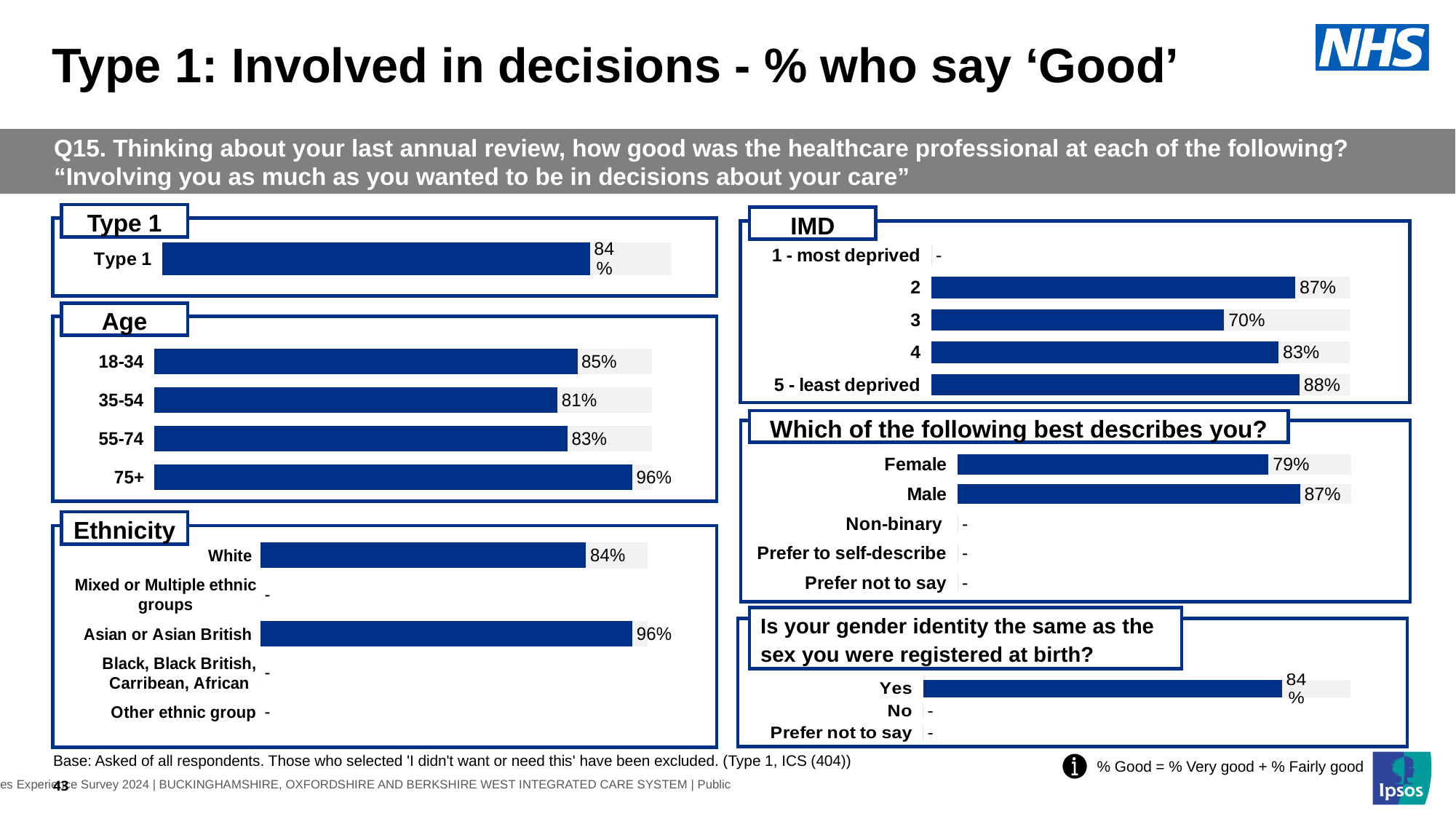
In the Ethnicity chart, what is the value for Asian or Asian British? 96% In the Ethnicity chart, which is larger, the value for White or the value for Asian or Asian British? Asian or Asian British In the 'Which of the following best describes you?' chart, which is larger, the value for Female or the value for Male? Male What kind of chart is the Age chart? Bar chart In the IMD chart, which group has the highest value? 5 - least deprived In the IMD chart, what is the difference between the values for 5 - least deprived and 3? 18 percentage points In the IMD chart, what is the value for group 3? 70% In the 'Which of the following best describes you?' chart, what is the value for Female? 79% In the Age chart, what is the difference between the values for 18-34 and 35-54? 4 percentage points In the Age chart, which age group has the lowest value? 35-54 In the 'Is your gender identity the same as the sex you were registered at birth?' chart, what is the value for Yes? 84% In the Age chart, what is the value for the 75+ age group? 96%